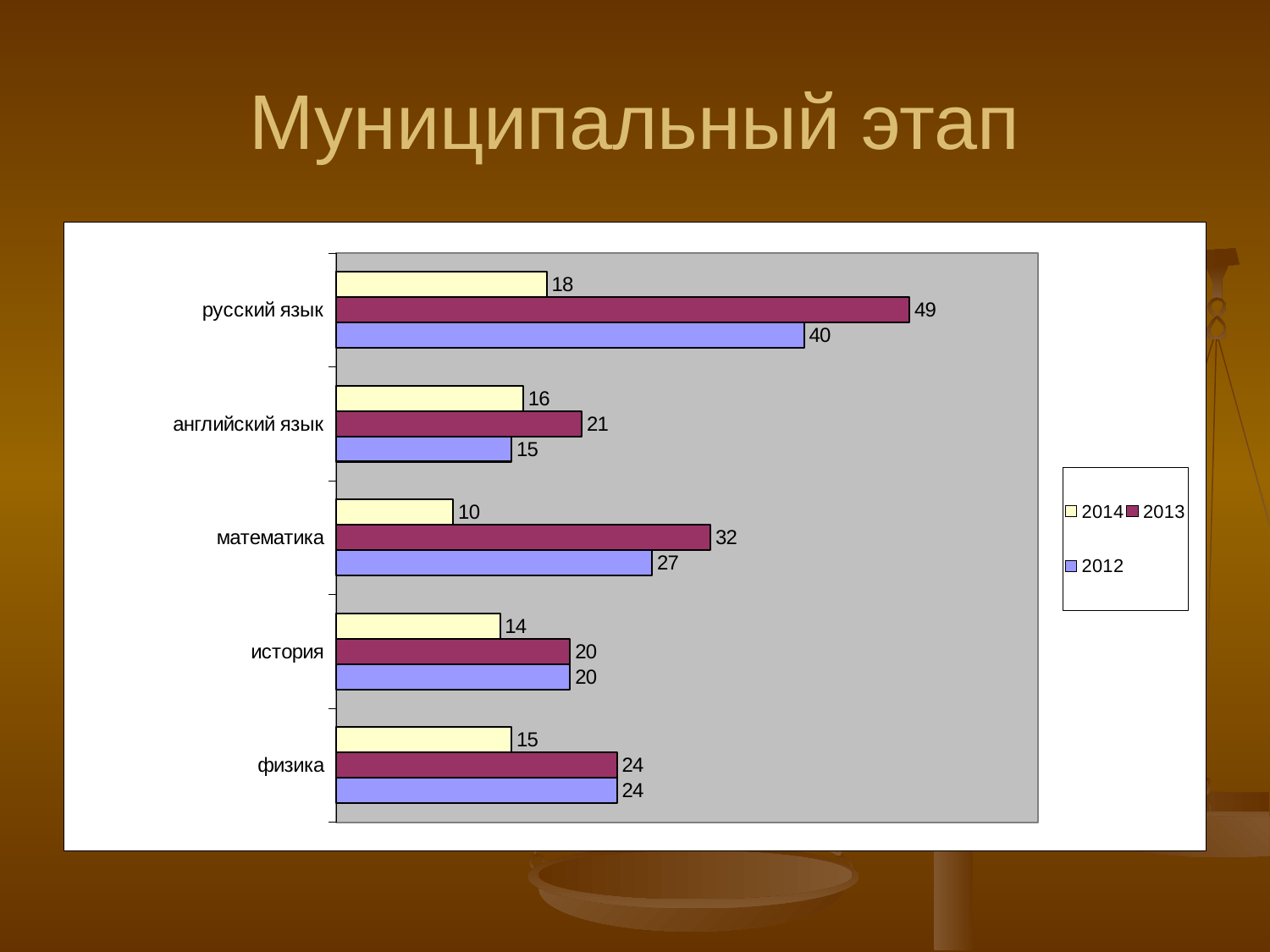
Which category has the lowest value in the 2014 series? математика How many categories are shown on the chart? 5 How many series does the legend list? 3 Which is larger for физика: the 2013 value or the 2014 value? 2013 What is the value for русский язык in the 2013 series? 49 What is the value for английский язык in the 2012 series? 15 What is the difference between the 2013 and 2014 values for русский язык? 31 What is the title of the slide? Муниципальный этап What is the value for математика in the 2014 series? 10 What is the difference between the 2013 and 2012 values for математика? 5 Which category has the highest value in the 2013 series? русский язык What kind of chart is shown on the slide? bar chart